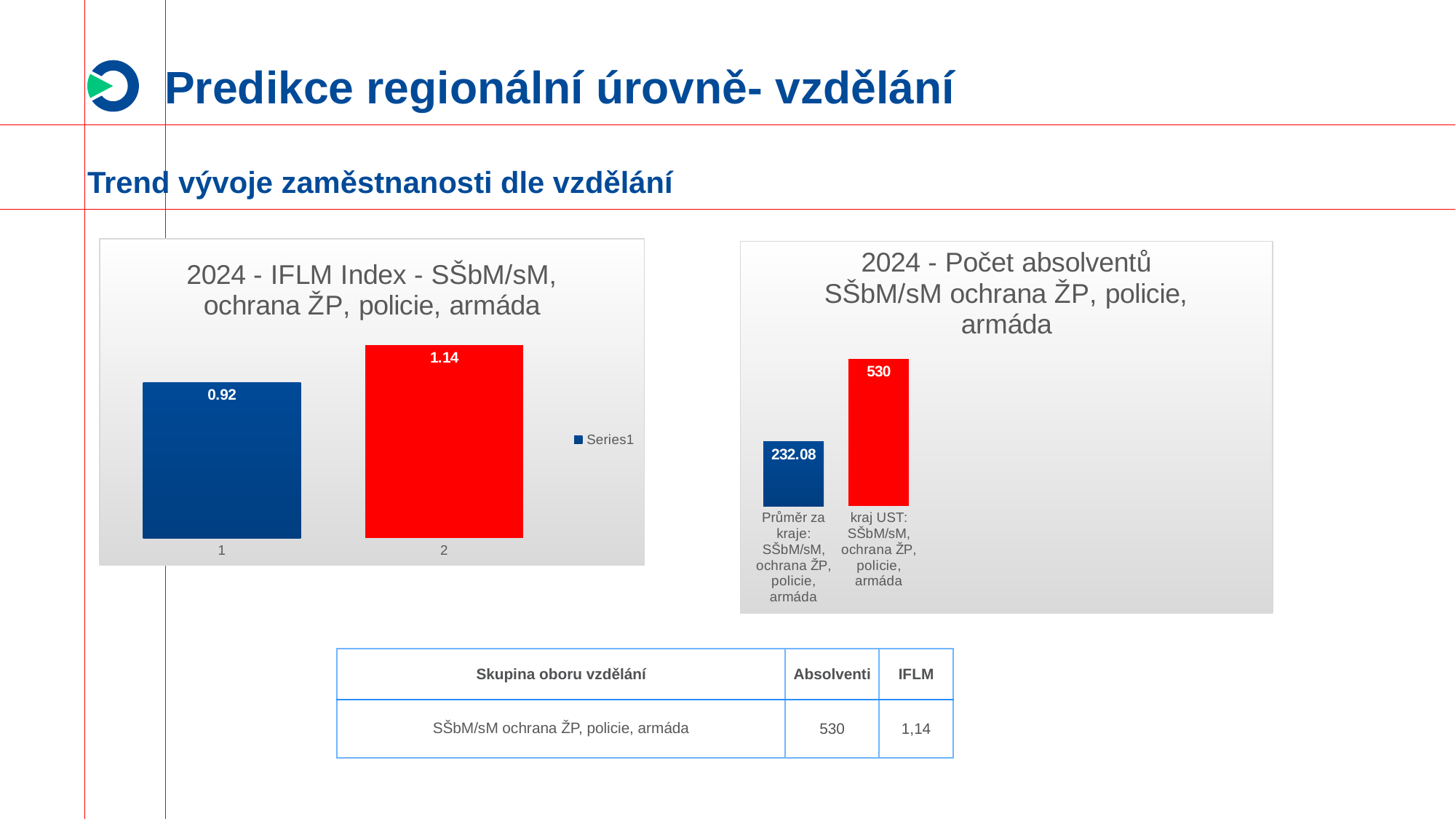
In the left chart (2024 - IFLM Index), what series name does the legend show? Series1 What type of chart is the right chart (2024 - Počet absolventů)? bar chart In the right chart (2024 - Počet absolventů), which category has the lower value? Průměr za kraje In the left chart (2024 - IFLM Index), how many bars are plotted? 2 In the right chart (2024 - Počet absolventů), what is the value for 'kraj UST'? 530 In the left chart (2024 - IFLM Index), which category has the higher value? 2 In the left chart (2024 - IFLM Index), what is the value for category 1? 0.92 In the right chart (2024 - Počet absolventů), what colour is the bar for 'kraj UST'? red In the left chart (2024 - IFLM Index), what is the difference between the values for category 2 and category 1? 0.22 In the left chart (2024 - IFLM Index), what is the value for category 2? 1.14 In the right chart (2024 - Počet absolventů), what is the difference between the value for 'kraj UST' and the value for 'Průměr za kraje'? 297.92 In the right chart (2024 - Počet absolventů), what is the value for 'Průměr za kraje'? 232.08